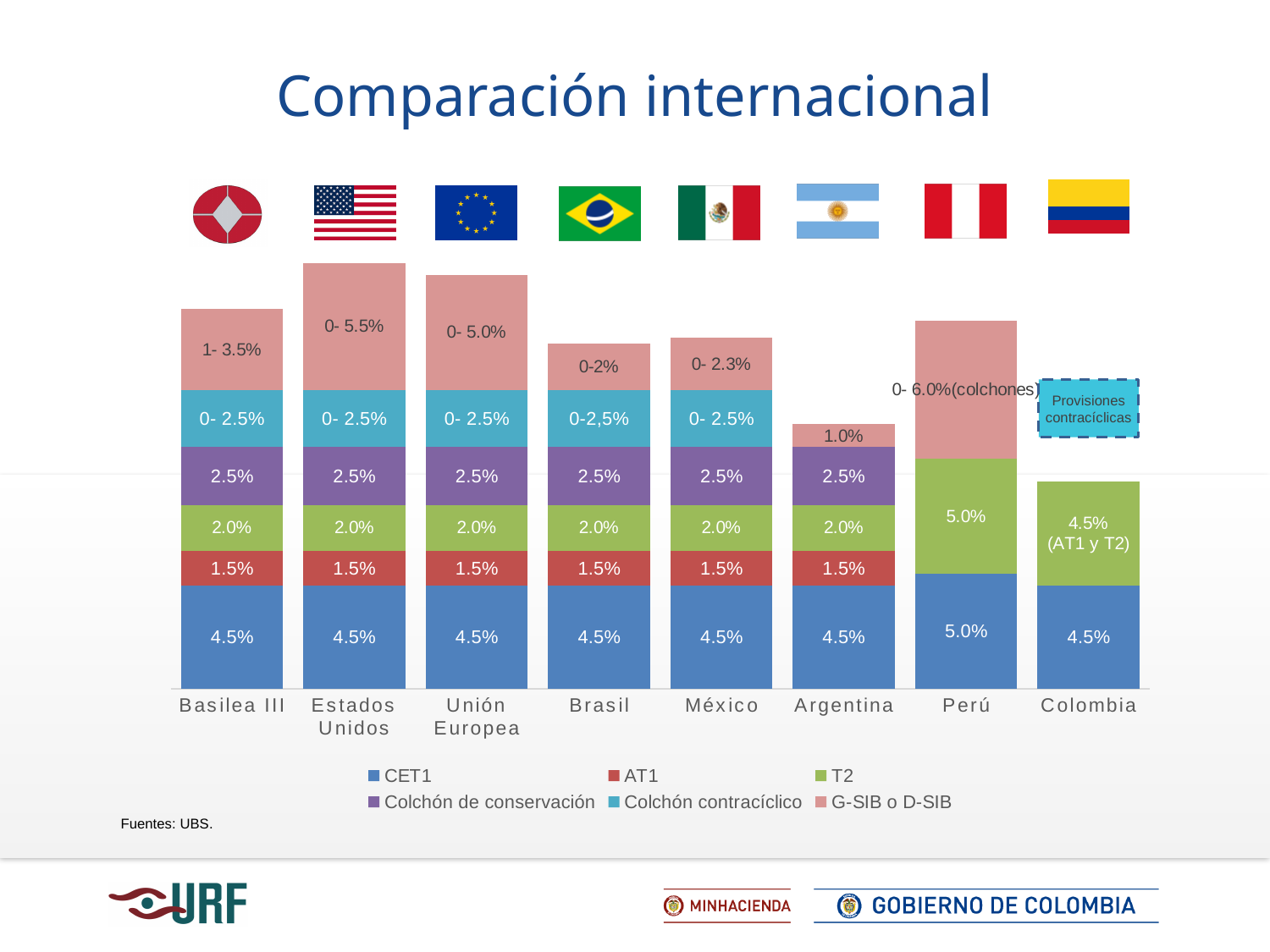
Which is larger, the CET1 value for Perú or the CET1 value for Basilea III? Perú What is the AT1 value for Brasil? 1.5% What is the CET1 value for Colombia? 4.5% What is the title of the chart? Comparación internacional What kind of chart is shown on the slide? Stacked bar chart How many series does the chart legend list? 6 What is the CET1 value for Perú? 5.0% What is the G-SIB o D-SIB value shown for Estados Unidos? 0- 5.5% What is the difference between the CET1 value for Perú and the CET1 value for México? 0.5% What is the T2 value for Perú? 5.0% How many countries or regimes are shown along the x axis of the chart? 8